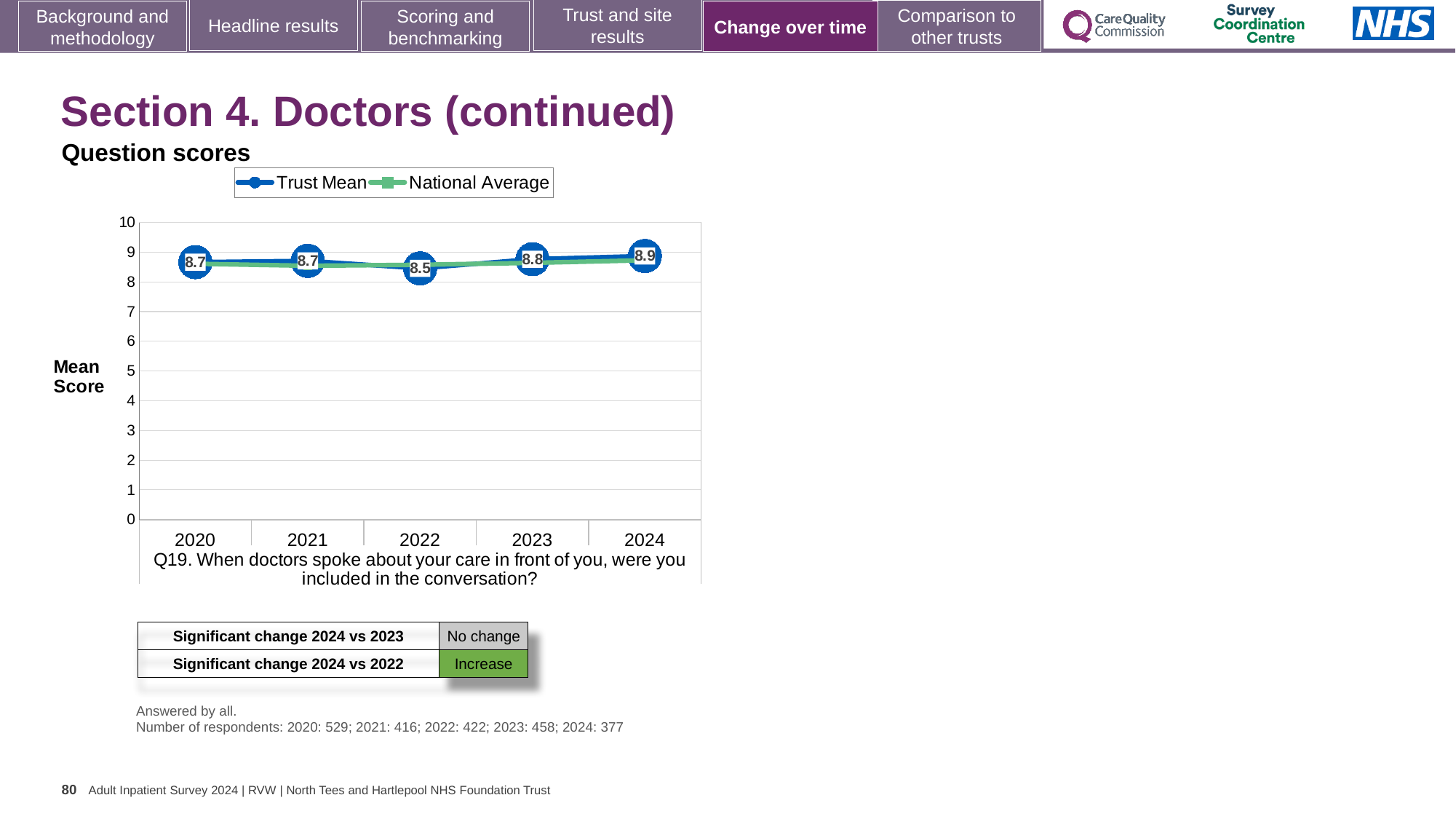
What is the difference between the Trust Mean scores for 2024 and 2022? 0.4 Does the Trust Mean score rise or fall from 2022 to 2024? Rise In which year is the Trust Mean score lowest? 2022 How many years are plotted on the x axis? 5 What is the Trust Mean score for 2024? 8.9 How many series does the legend list? 2 What is the Trust Mean score for 2022? 8.5 Which year has the larger Trust Mean score, 2023 or 2022? 2023 Is the National Average value for 2020 greater or less than 8? greater In which year is the Trust Mean score highest? 2024 What kind of chart is shown? Line chart What is the Trust Mean score for 2020? 8.7